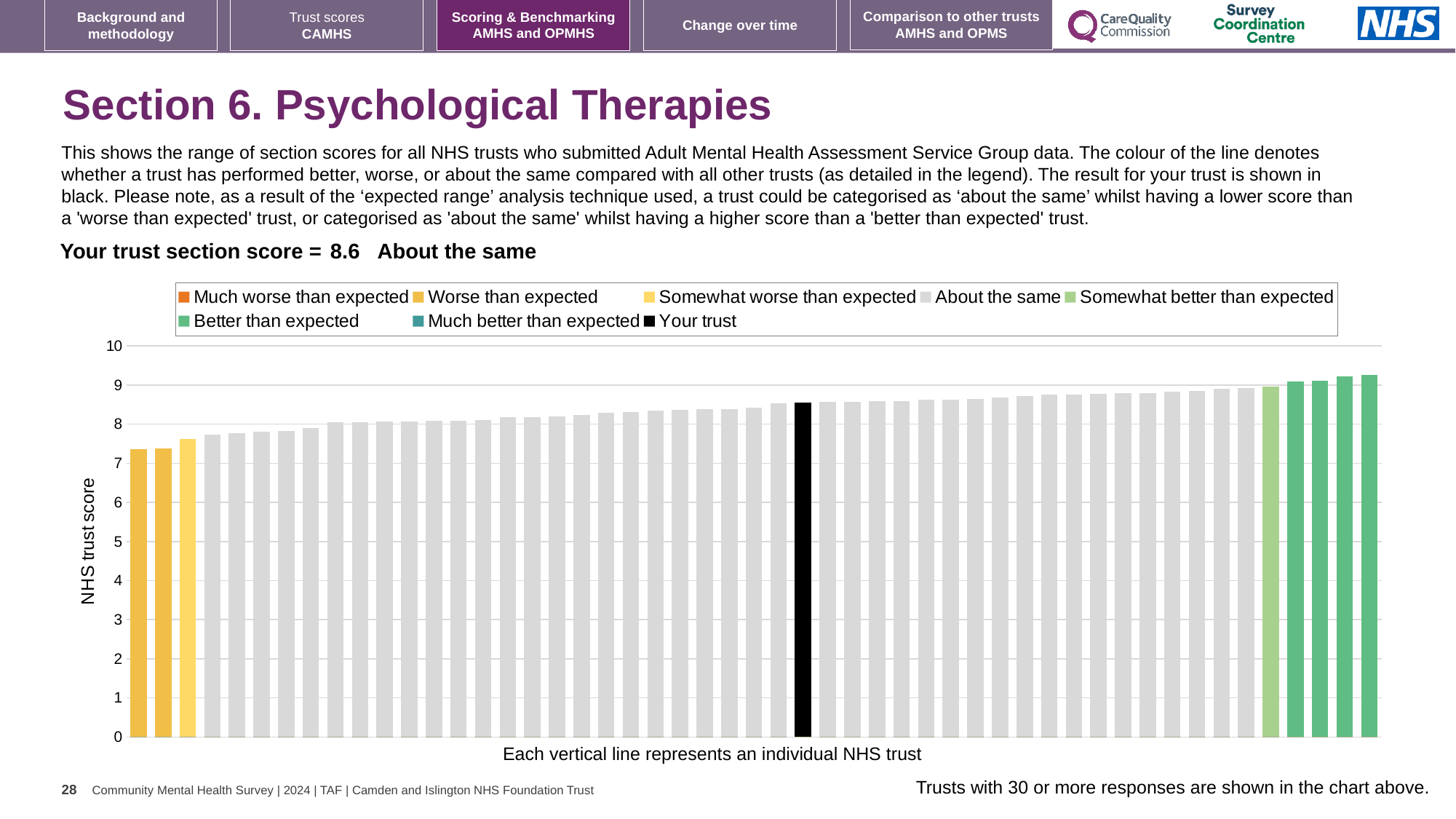
Is the value of the leftmost bar greater or less than 8? less Is the value of the rightmost bar greater or less than 9? greater What is the label on the y axis of the chart? NHS trust score How many entries does the chart legend list? 8 Is the value for your trust's bar greater or less than 8? greater What is the section score for your trust shown on the slide? 8.6 How many bars are coloured as 'Better than expected'? 4 How many bars are coloured as 'Worse than expected'? 2 What kind of chart is shown on the slide? bar chart Do the bar values rise or fall from left to right along the x axis? rise Which category is your trust placed in for this section? About the same What colour is the bar representing your trust? black